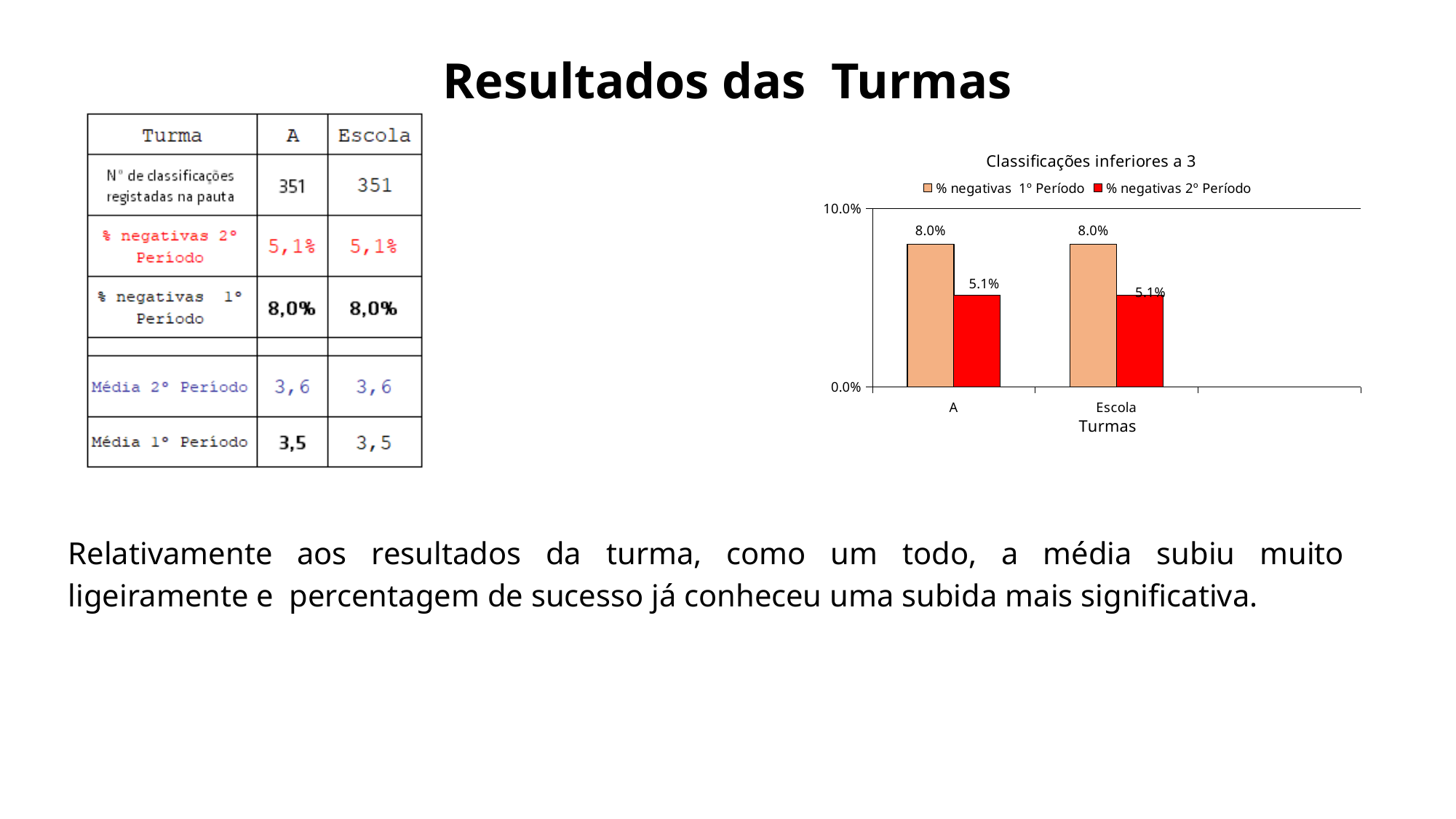
What type of chart is shown on the slide? bar chart Is the value of % negativas 2º Período for category A greater or less than 10.0%? less What is the value of % negativas 1º Período for category A? 8.0% How many series does the chart legend list? 2 What is the difference between % negativas 1º Período and % negativas 2º Período for Escola? 2.9% How many categories are shown on the x axis of the chart? 2 For category A, which series has the larger value: % negativas 1º Período or % negativas 2º Período? % negativas 1º Período What is the label of the x axis of the chart? Turmas What is the title of the chart? Classificações inferiores a 3 What is the value of % negativas 2º Período for Escola? 5.1% What is the value of % negativas 1º Período for Escola? 8.0% What is the value of % negativas 2º Período for category A? 5.1%